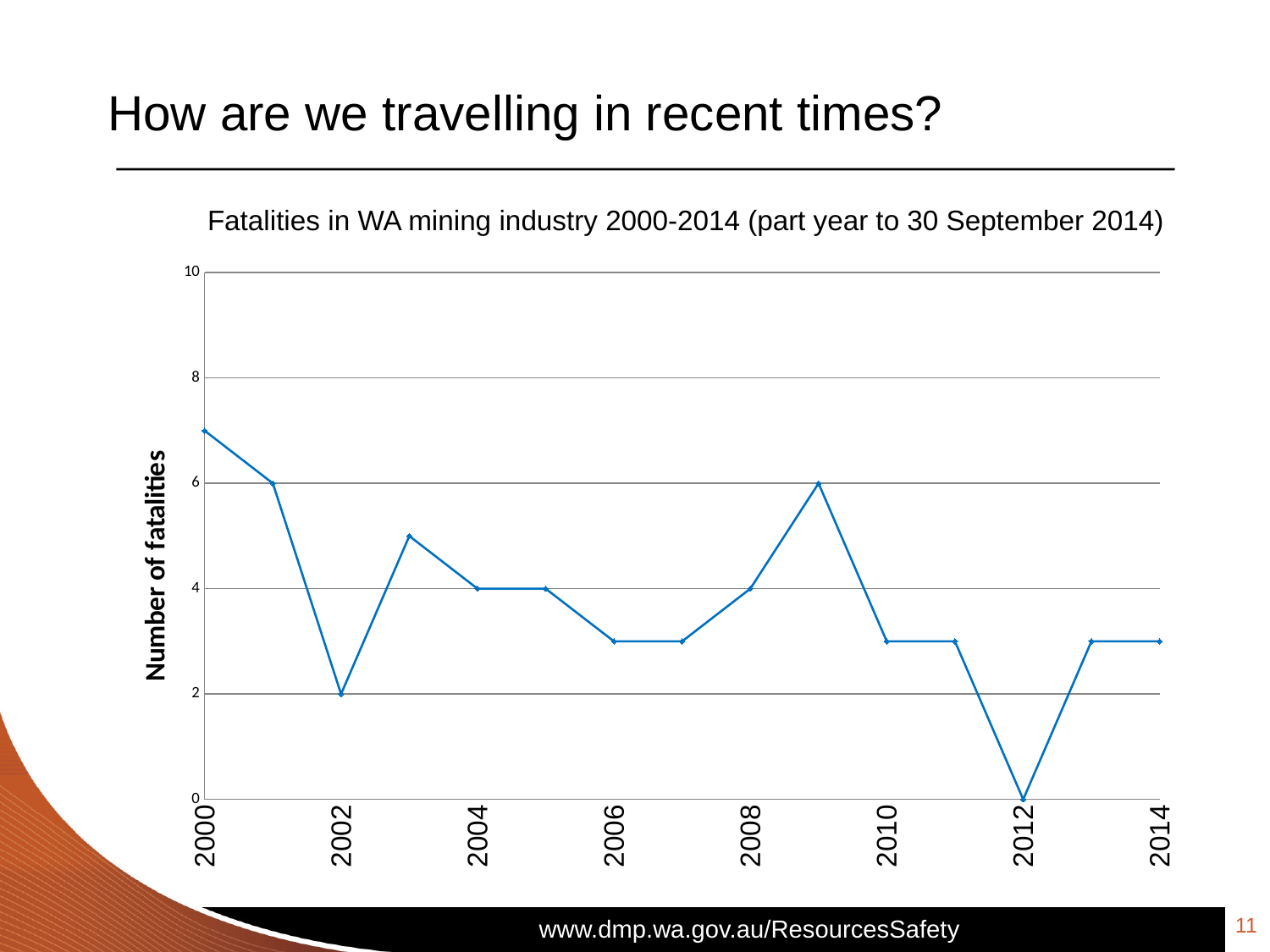
What is the number of fatalities in 2002? 2 What is the difference in the number of fatalities between 2009 and 2002? 4 Which year has the lowest number of fatalities? 2012 What type of chart is shown on the slide? Line chart What is the number of fatalities in 2009? 6 Is the number of fatalities in 2000 greater or less than 6? greater What is the number of fatalities in 2012? 0 Which year has the highest number of fatalities? 2000 What is the number of fatalities in 2004? 4 What is the label on the vertical axis of the chart? Number of fatalities How many years are plotted on the chart? 15 Which year had more fatalities, 2001 or 2008? 2001